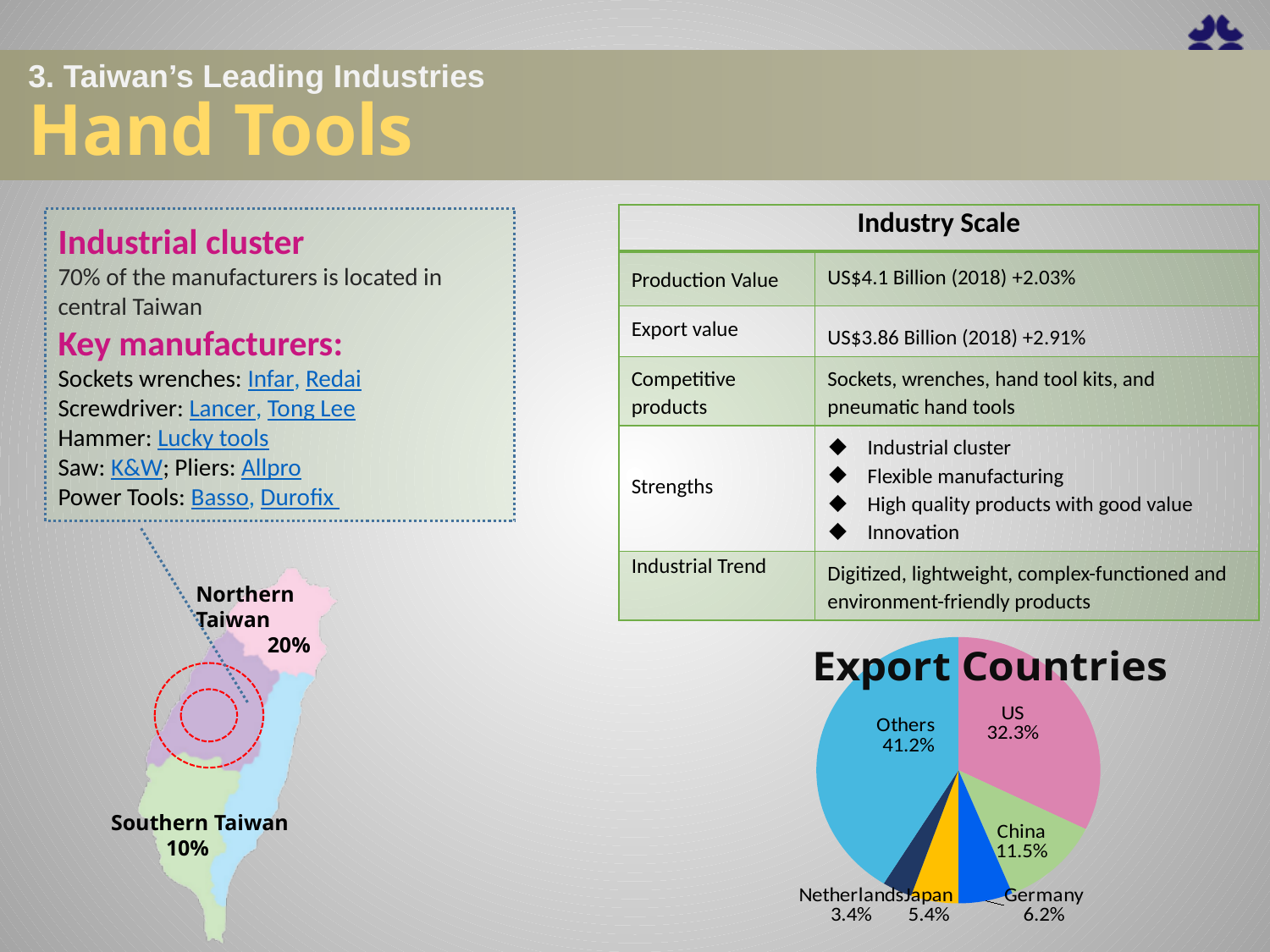
In the Export Countries pie chart, which slice is the largest? Others In the Export Countries pie chart, which named country has the smallest share? Netherlands In the Export Countries pie chart, how many slices are there? 6 In the Export Countries pie chart, what share does Japan have? 5.4% In the Export Countries pie chart, what share does the US have? 32.3% What kind of chart is the Export Countries chart? pie chart In the Export Countries pie chart, what share does Germany have? 6.2% What is the title of the pie chart on the slide? Export Countries In the Export Countries pie chart, what share does China have? 11.5% In the Export Countries pie chart, what share does the Netherlands have? 3.4% In the Export Countries pie chart, what is the difference between the US share and the China share? 20.8% In the Export Countries pie chart, which is larger, Germany or Japan? Germany